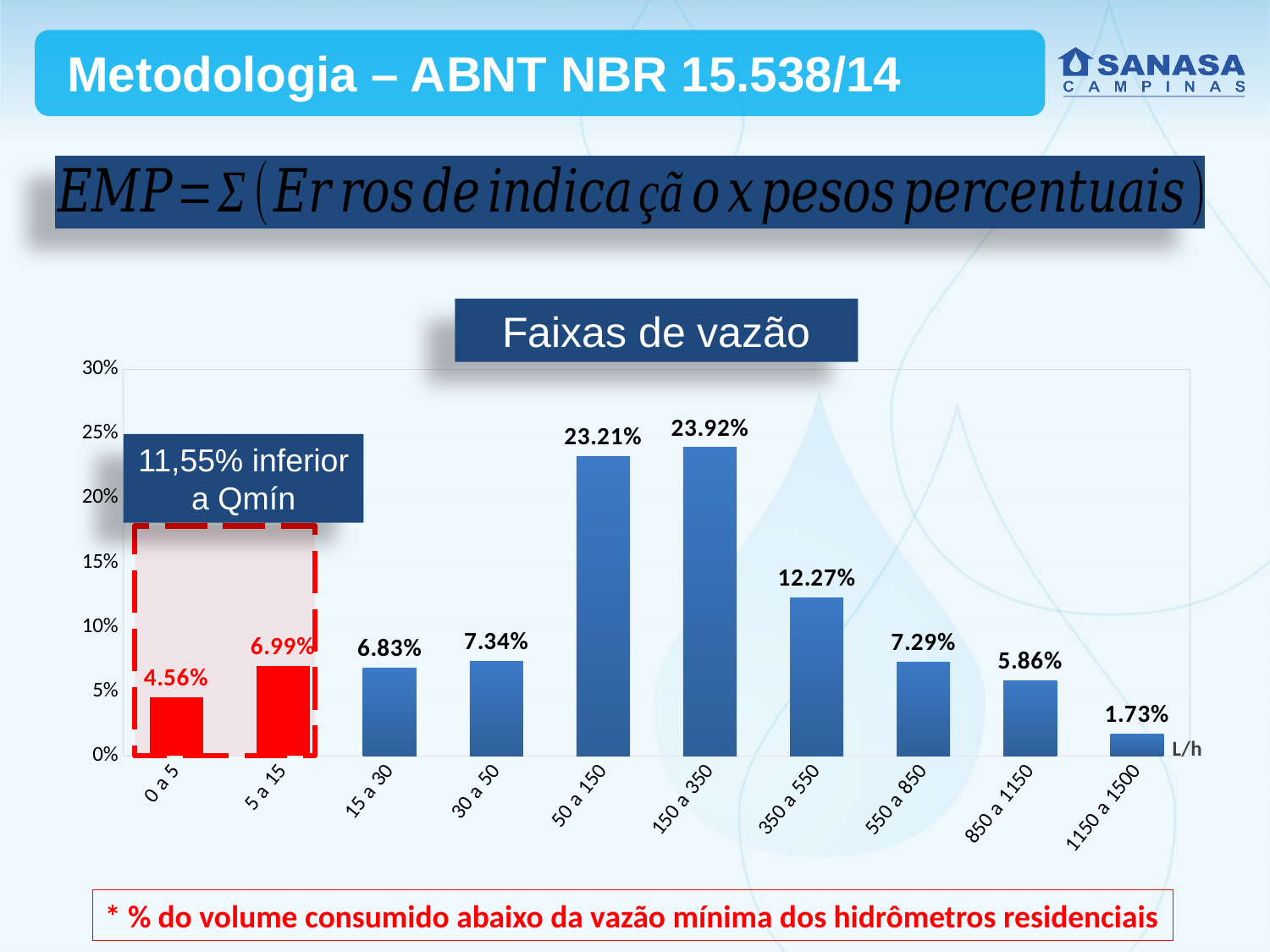
What is the total of the two red bars (0 a 5 and 5 a 15)? 11.55% What is the value for the 150 a 350 flow range? 23.92% What is the title of the chart? Faixas de vazão Which flow range has the lowest value? 1150 a 1500 How many flow range categories are shown on the x axis? 10 What is the value for the 350 a 550 flow range? 12.27% Is the value for 550 a 850 greater or less than 10%? less What is the value for the 0 a 5 flow range? 4.56% Which flow range has the highest value? 150 a 350 What kind of chart is shown on the slide? bar chart What is the difference between the values for 50 a 150 and 350 a 550? 10.94% Which is larger, the value for 5 a 15 or the value for 15 a 30? 5 a 15